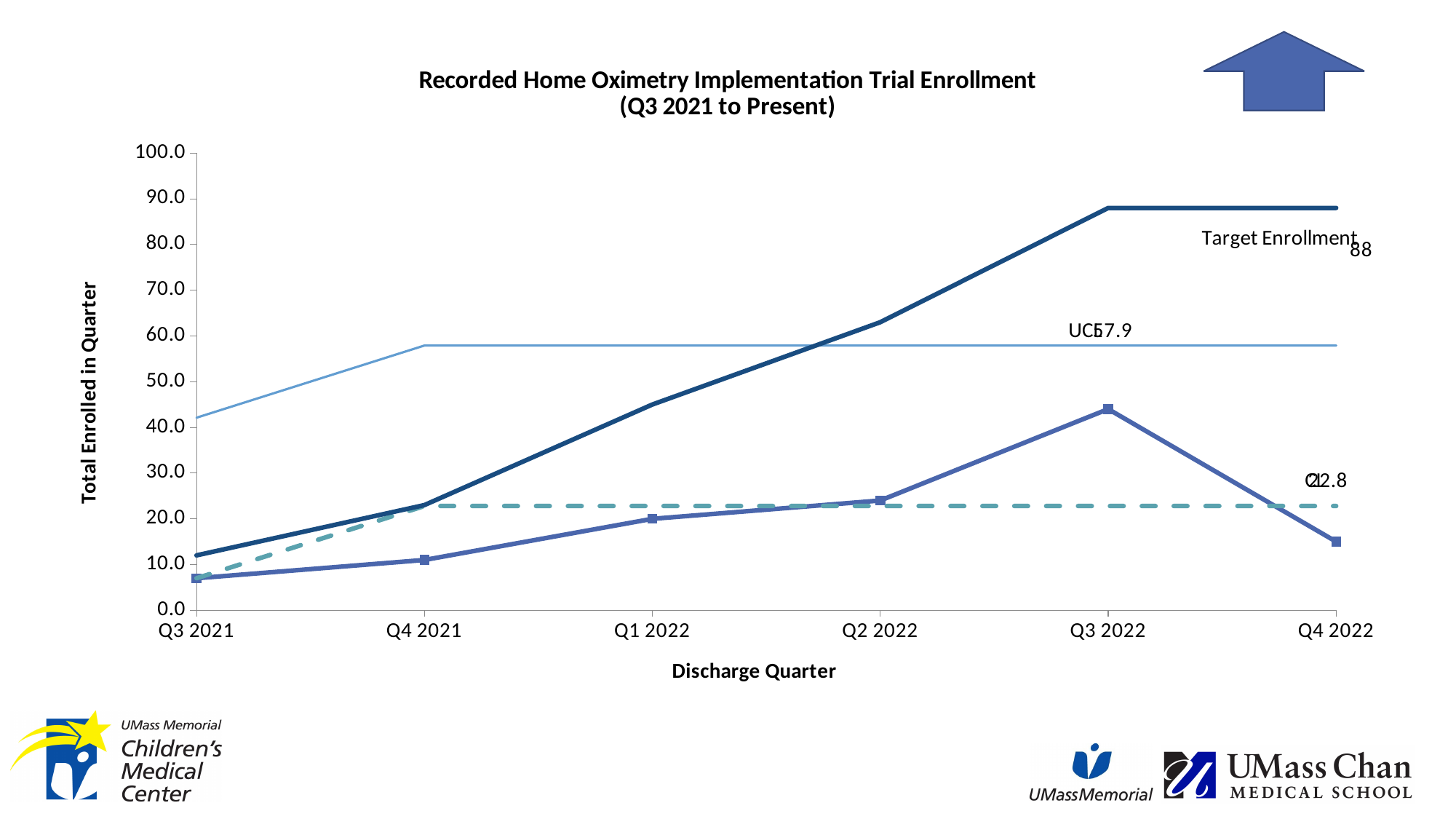
What is the title of the x axis? Discharge Quarter What is the labelled value of the Target Enrollment line at the end of the chart? 88 Is the value of the marked enrollment line for Q4 2022 greater or less than 20? less In which quarter does the marked enrollment line reach its highest value? Q3 2022 How many discharge quarters are shown on the x axis? 6 What kind of chart is shown on the slide? line chart In which quarter is the marked enrollment line at its lowest value? Q3 2021 What value is printed for the CL line? 22.8 Is the value of the marked enrollment line for Q3 2022 greater or less than 40? greater What value is printed for the UCL line? 57.9 What is the difference between the UCL value and the CL value? 35.1 Does the Target Enrollment line rise or fall from Q3 2021 to Q3 2022? rise